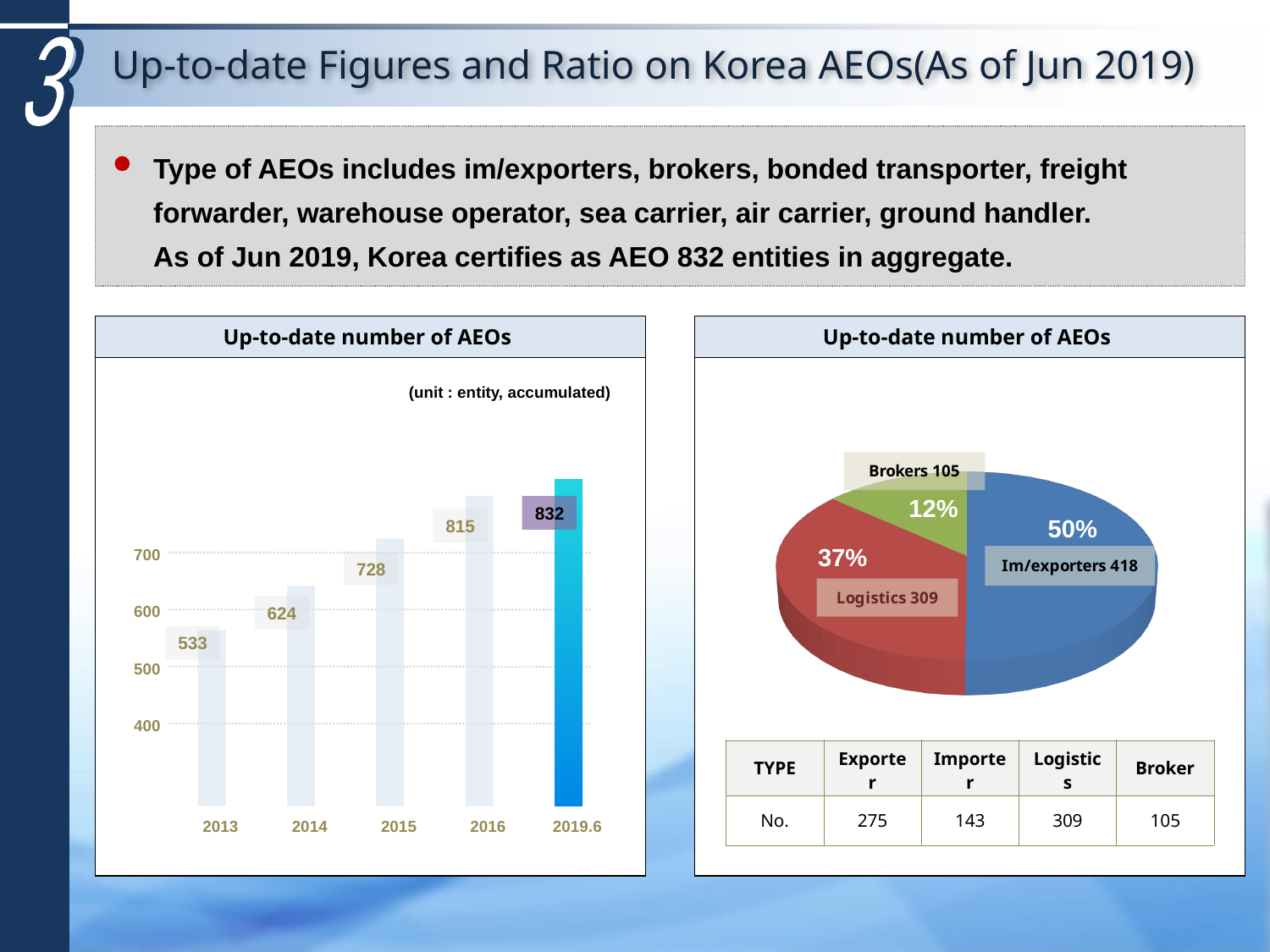
How many bars are shown in the bar chart on the left? 5 In the bar chart on the left, what is the difference between the values for 2016 and 2014? 191 In the bar chart on the left, what is the value for 2015? 728 What kind of chart is the chart on the left? bar chart What kind of chart is the chart on the right? pie chart In the bar chart on the left, which category has the highest value? 2019.6 In the bar chart on the left, what is the value for 2019.6? 832 In the pie chart on the right, what is the value for Brokers? 105 In the bar chart on the left, which year has the lowest value? 2013 In the bar chart on the left, do the values rise or fall from 2013 to 2019.6? rise In the pie chart on the right, which slice is the largest? Im/exporters In the pie chart on the right, what share does Logistics have? 37%